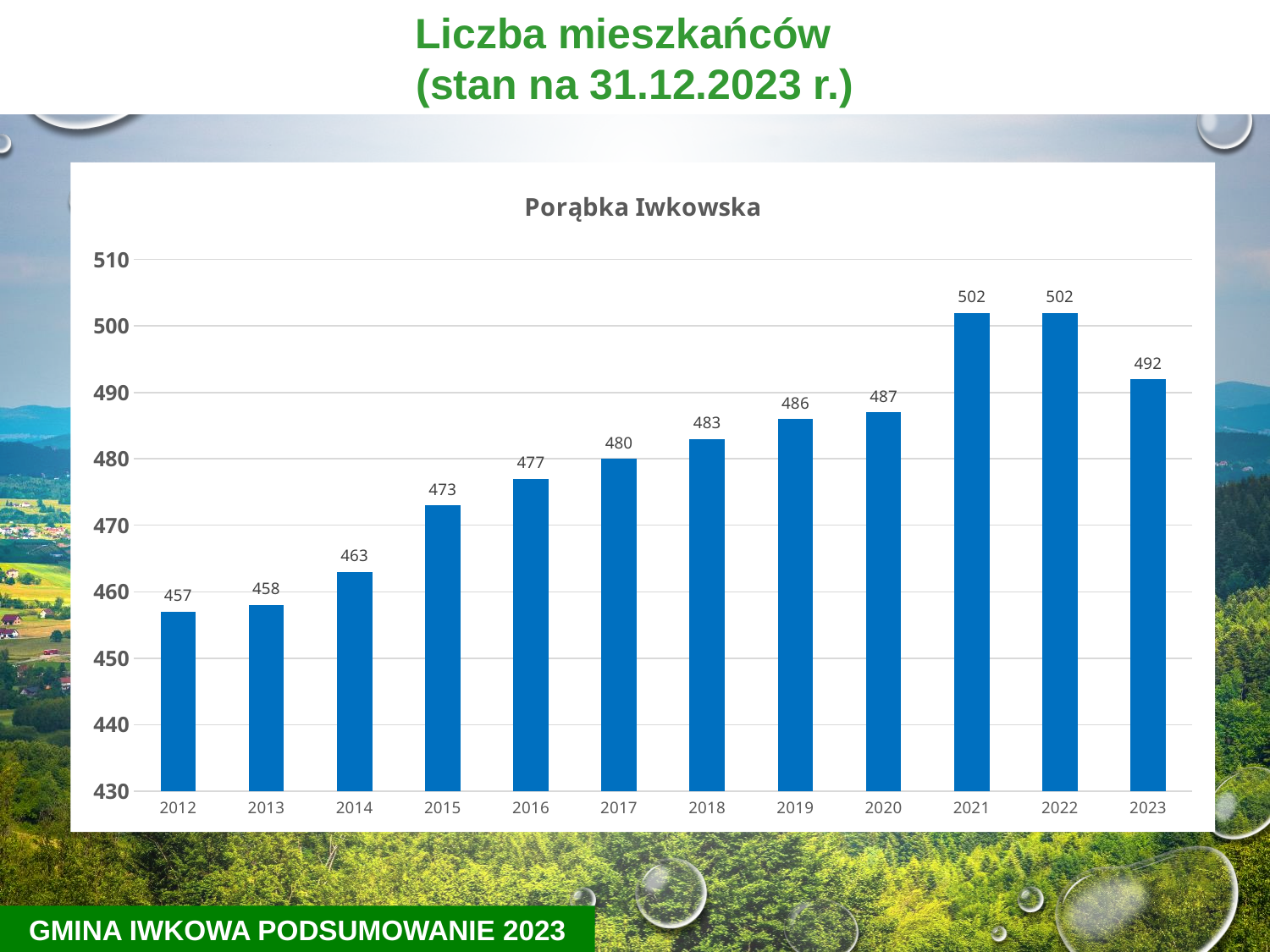
What is the value for 2012? 457 What is the value for 2019? 486 What is the difference between the values for 2015 and 2012? 16 What is the highest value shown on the chart? 502 How many years are shown on the x axis? 12 What is the value for 2023? 492 What kind of chart is this? bar chart Is the value for 2014 greater or less than 470? less Which is larger, the value for 2016 or the value for 2018? 2018 Which year has the lowest value? 2012 What is the title of the chart? Porąbka Iwkowska What is the difference between the values for 2022 and 2023? 10